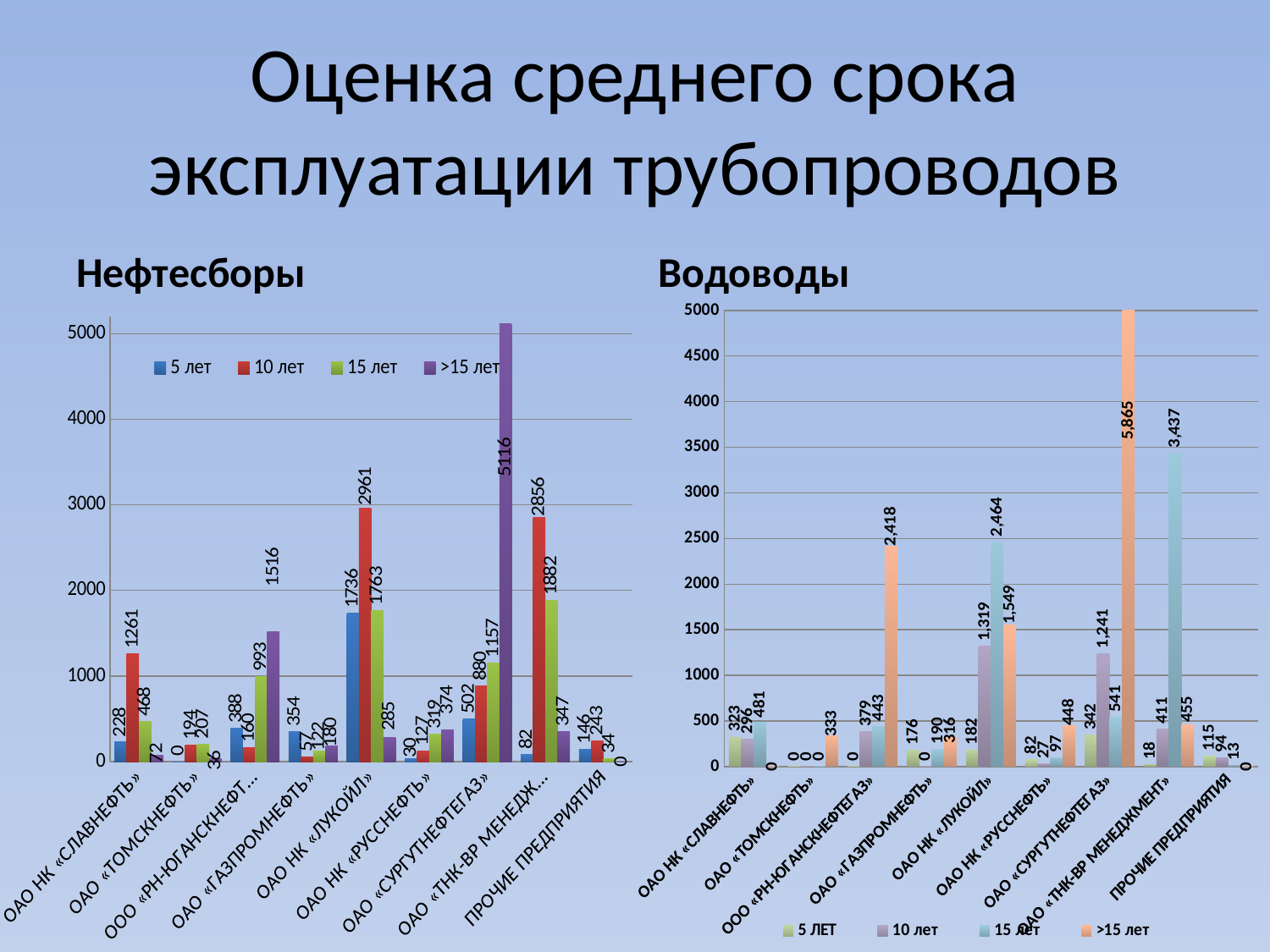
In the Водоводы chart, what is the value of the >15 лет series for ОАО «СУРГУТНЕФТЕГАЗ»? 5,865 In the Нефтесборы chart, is the >15 лет value for ОАО «СУРГУТНЕФТЕГАЗ» greater or less than 5000? greater In the Водоводы chart, which is larger for ОАО НК «ЛУКОЙЛ»: the 15 лет value or the >15 лет value? 15 лет In the Водоводы chart, what is the value of the 15 лет series for ОАО «ТНК-ВР МЕНЕДЖМЕНТ»? 3,437 In the Нефтесборы chart, which category has the highest 10 лет value? ОАО НК «ЛУКОЙЛ» What kind of chart is the Водоводы chart? Bar chart In the Нефтесборы chart, what is the value of the 10 лет series for ОАО НК «ЛУКОЙЛ»? 2961 How many series does the legend of the Нефтесборы chart list? 4 In the Нефтесборы chart, what is the difference between the 10 лет value for ОАО НК «ЛУКОЙЛ» (2961) and the 10 лет value for ОАО «ТНК-ВР МЕНЕДЖ...» (2856)? 105 In the Нефтесборы chart, what is the value of the >15 лет series for ОАО «СУРГУТНЕФТЕГАЗ»? 5116 How many categories are shown on the x axis of the Водоводы chart? 9 In the Водоводы chart, which category has the highest 15 лет value? ОАО «ТНК-ВР МЕНЕДЖМЕНТ»